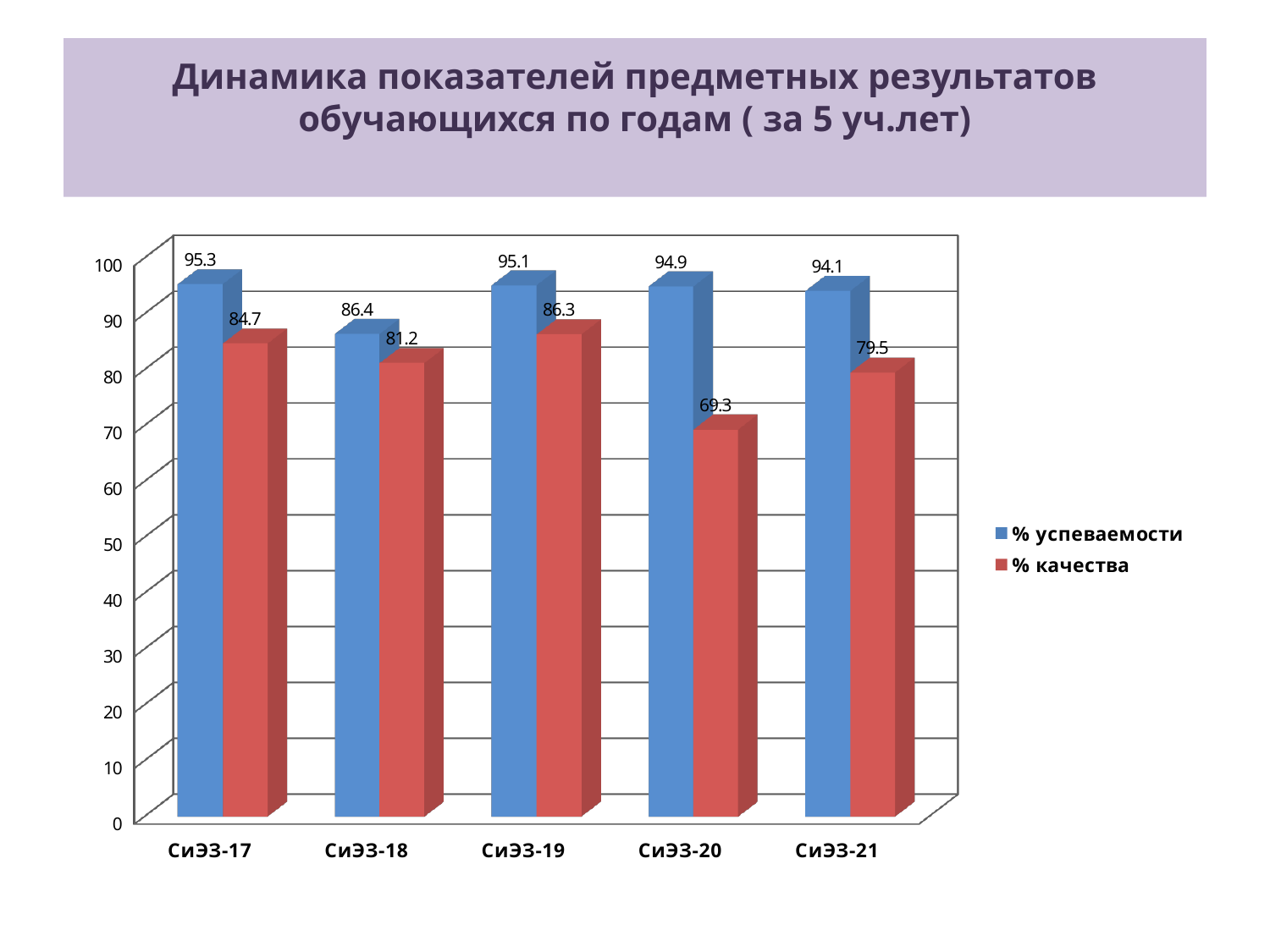
What is the difference between % успеваемости and % качества for СиЭЗ-20? 25.6 What is the % качества value for СиЭЗ-21? 79.5 What is the % качества value for СиЭЗ-20? 69.3 Which colour represents % качества in the chart? Red Which category has the lowest % качества value? СиЭЗ-20 How many categories are shown on the x axis? 5 How many series does the legend list? 2 What is the difference in % качества between СиЭЗ-19 and СиЭЗ-18? 5.1 Which is larger: % успеваемости for СиЭЗ-18 or % успеваемости for СиЭЗ-19? СиЭЗ-19 What kind of chart is shown on the slide? Bar chart Which category has the highest % успеваемости value? СиЭЗ-17 What is the % успеваемости value for СиЭЗ-17? 95.3